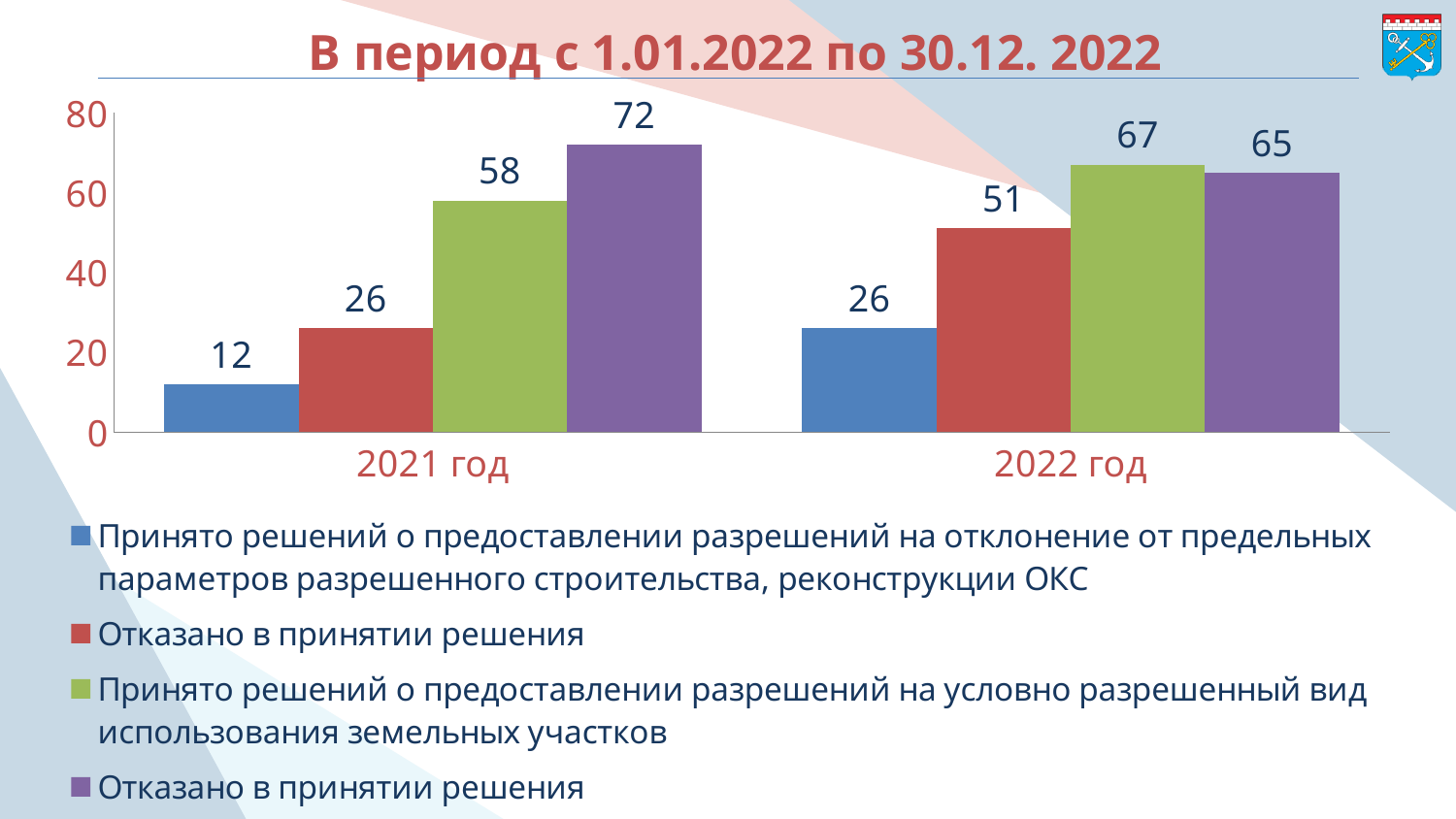
How many categories are shown on the x axis? 2 What type of chart is shown on the slide? bar chart What is the value of the purple series (the last 'Отказано в принятии решения') for 2021 год? 72 What is the value of the blue series (решений о предоставлении разрешений на отклонение от предельных параметров) for 2021 год? 12 What is the value of the blue series (решений о предоставлении разрешений на отклонение от предельных параметров) for 2022 год? 26 Which is larger: the green series value for 2021 год or the green series value for 2022 год? 2022 год What is the difference between the red series values for 2022 год and 2021 год? 25 Which series has the highest value for 2021 год? the purple series (Отказано в принятии решения, last legend entry) How many series does the legend list? 4 Which series has the lowest value for 2022 год? the blue series (Принято решений о предоставлении разрешений на отклонение от предельных параметров разрешенного строительства, реконструкции ОКС) What is the title of the chart? В период с 1.01.2022 по 30.12. 2022 What is the value of the green series (разрешений на условно разрешенный вид использования земельных участков) for 2022 год? 67